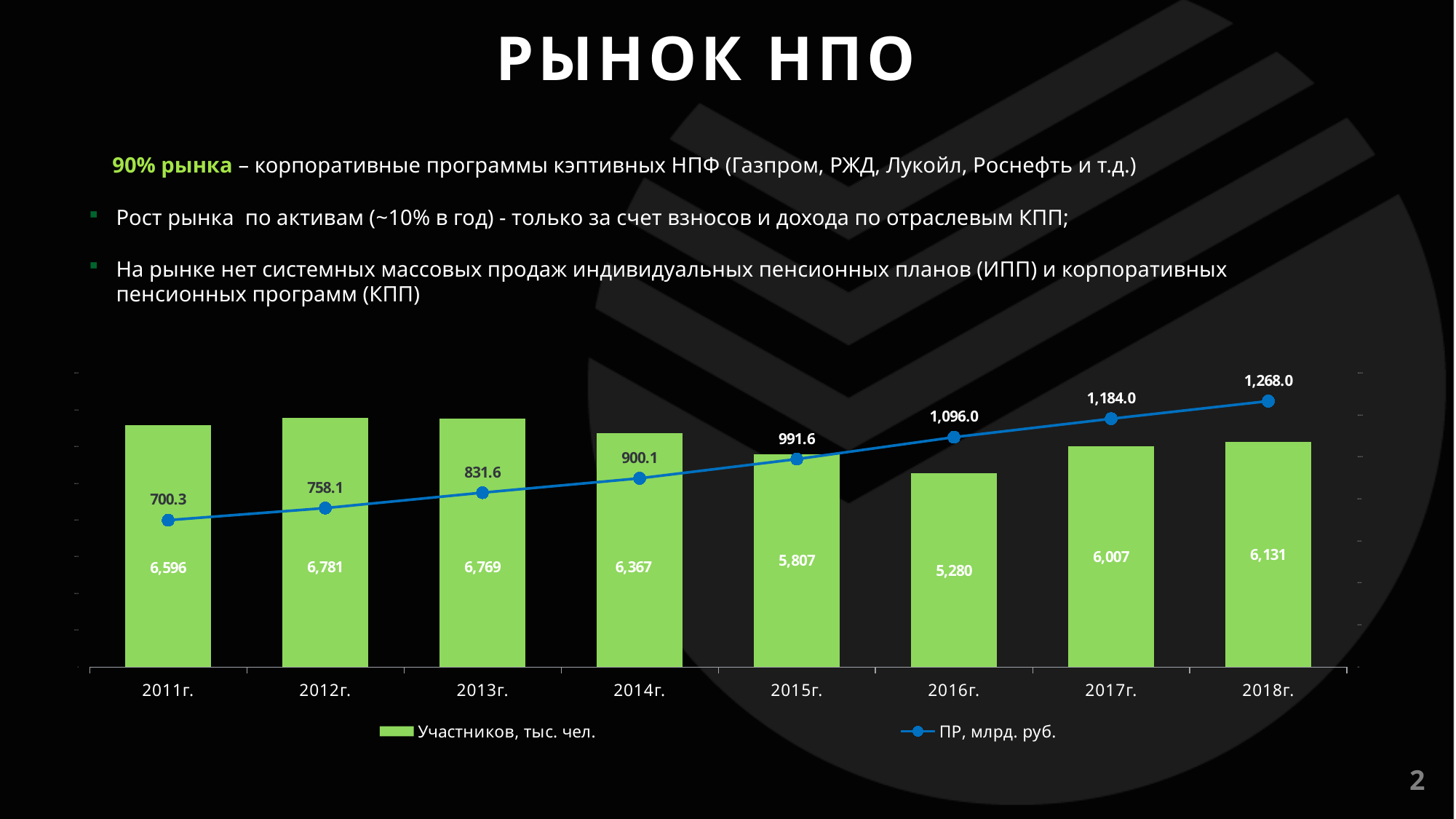
Which year has the highest value of ПР, млрд. руб.? 2018г. How many series does the chart legend list? 2 Which year has the lowest value of Участников, тыс. чел.? 2016г. Which is larger, the Участников, тыс. чел. value for 2017г. or for 2018г.? 2018г. What is the value of Участников, тыс. чел. for 2016г.? 5,280 Which year has the highest value of Участников, тыс. чел.? 2012г. What is the value of Участников, тыс. чел. for 2011г.? 6,596 What is the difference between the Участников, тыс. чел. values for 2012г. and 2016г.? 1,501 How many years are shown on the x axis of the chart? 8 What is the difference between the ПР, млрд. руб. values for 2018г. and 2011г.? 567.7 What is the value of ПР, млрд. руб. for 2014г.? 900.1 Does the ПР, млрд. руб. series rise or fall from 2011г. to 2018г.? rise